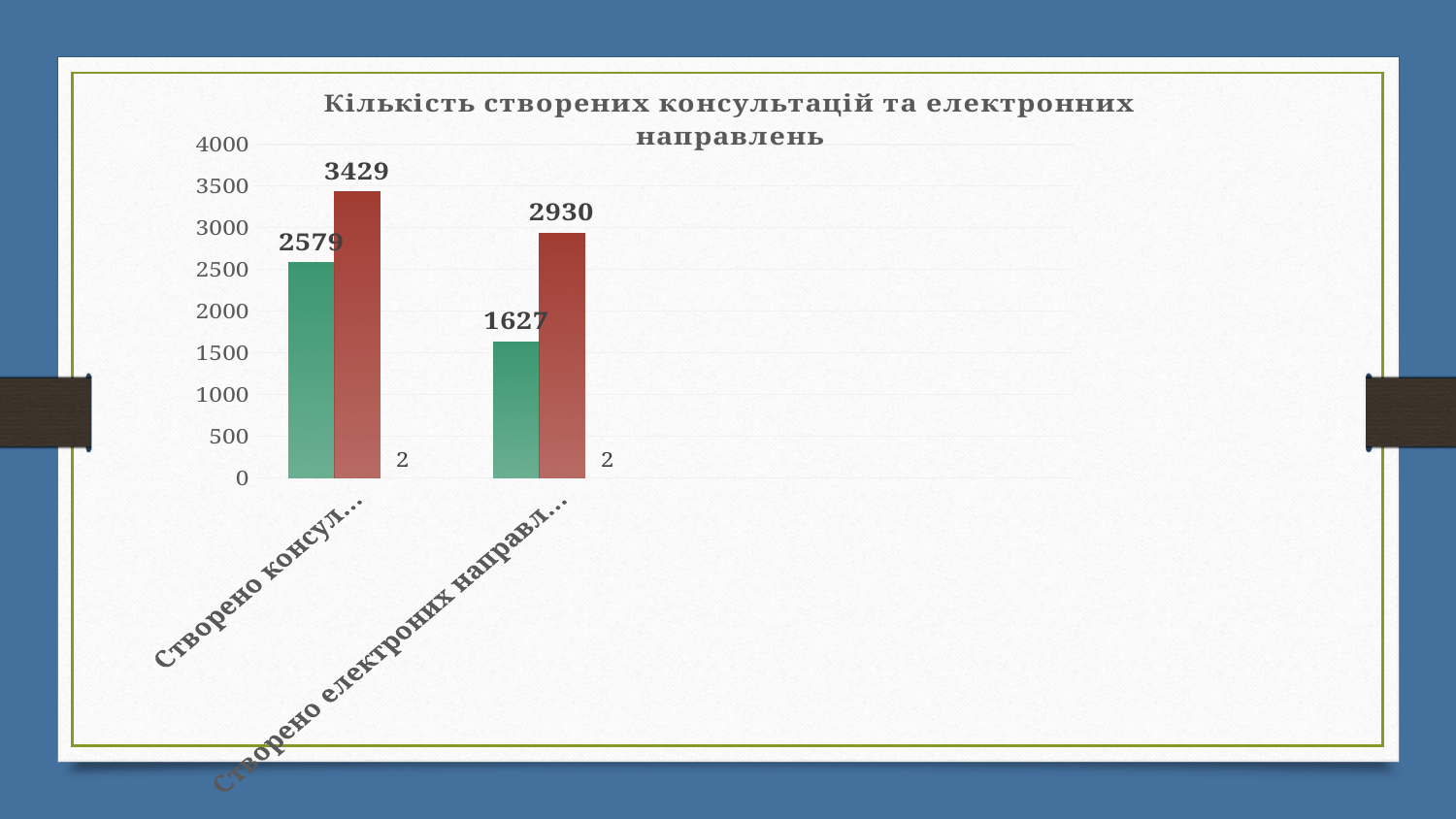
What is the value of the red bar in the right group ("Створено електроних направл...")? 2930 Which is larger: the green bar in the left group or the green bar in the right group? The green bar in the left group (2579) What is the value of the green bar in the left group ("Створено консул...")? 2579 Which bar has the highest value on the chart? The red bar in the left group (3429) Is the value of the red bar in the right group greater or less than 2500? greater What is the difference between the red bar and the green bar in the left group? 850 What is the title of the chart? Кількість створених консультацій та електронних направлень What kind of chart is shown on the slide? Bar chart Among the green and red bars, which has the lowest value? The green bar in the right group (1627) What is the value of the green bar in the right group ("Створено електроних направл...")? 1627 What is the difference between the red bar and the green bar in the right group? 1303 What is the value of the red bar in the left group ("Створено консул...")? 3429